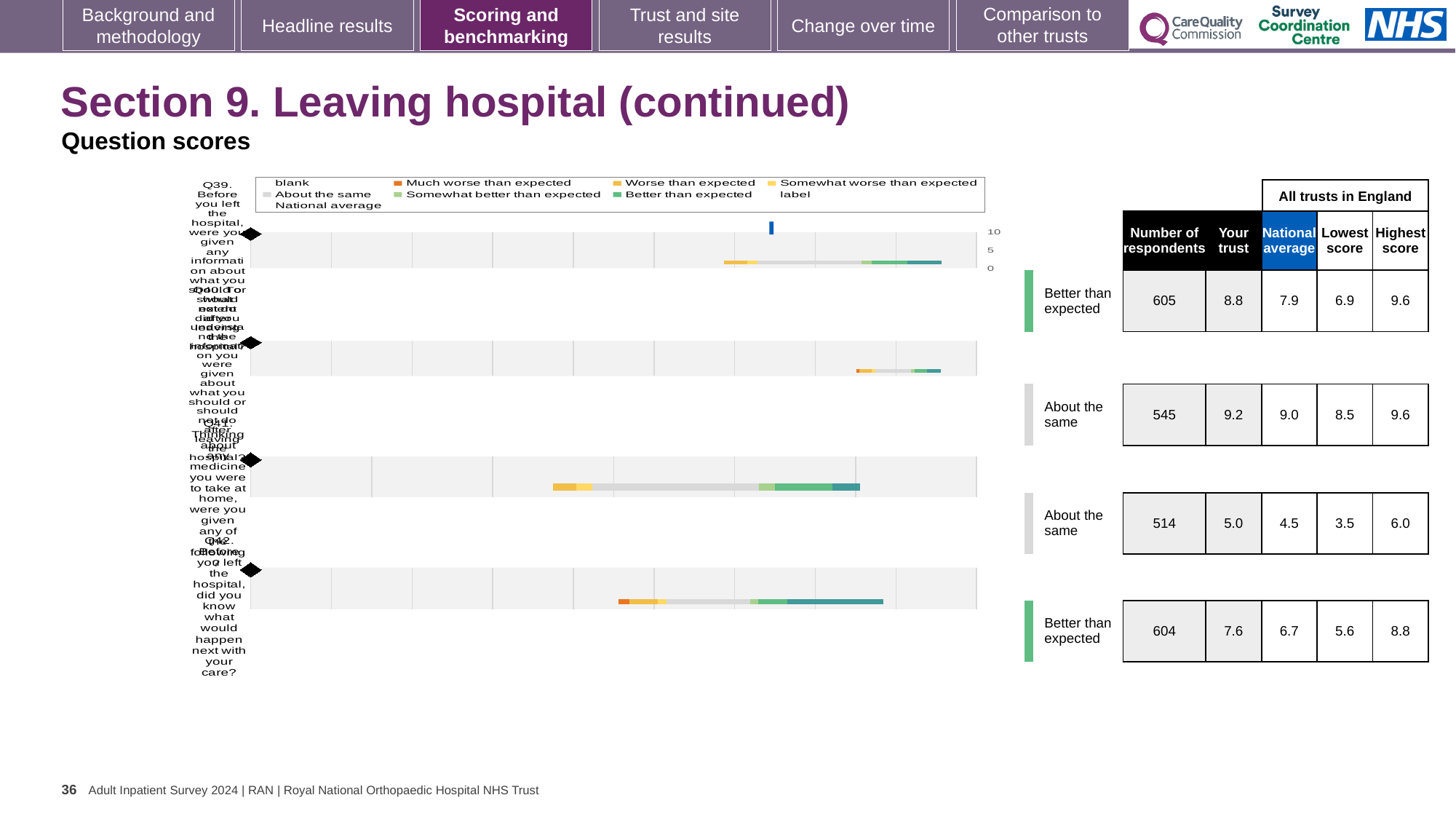
What is the 'Your trust' score for Q39 (the first row)? 8.8 How many question rows (diamond markers) are plotted in the chart? 4 By how much does the 'Your trust' score for Q39 exceed the national average? 0.9 What is the national average for Q42 (the last row)? 6.7 What is the highest 'Your trust' score among the four rows? 9.2 What kind of chart is used to show the question scores on this slide? bar chart What benchmark category is shown for Q39 (the first row)? Better than expected What is the 'Your trust' score for Q42 (the last row)? 7.6 For Q42, which is larger: the 'Your trust' score or the national average? Your trust (7.6) How many respondents are listed for Q39 (the first row)? 605 What is the difference between the highest score and the lowest score for Q42 (the last row)? 3.2 What is the lowest 'Your trust' score among the four rows? 5.0